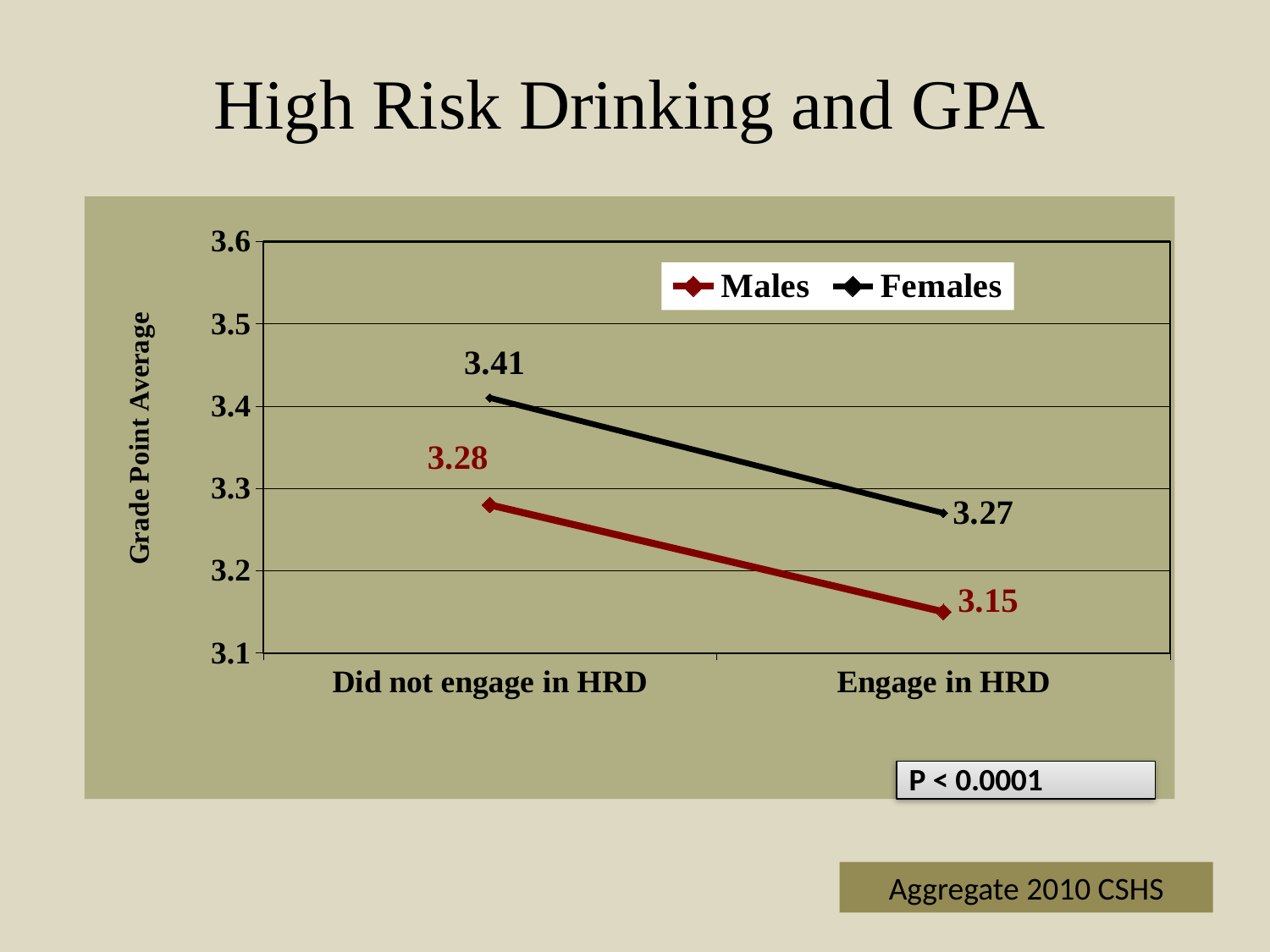
What is the difference between the Females GPA and the Males GPA for those who engage in HRD? 0.12 What is the label of the y axis? Grade Point Average What is the GPA for Females who did not engage in HRD? 3.41 How much does the Females GPA drop from 'Did not engage in HRD' to 'Engage in HRD'? 0.14 How many categories are shown on the x axis? 2 What is the GPA for Males who did not engage in HRD? 3.28 How many series does the legend list? 2 What is the GPA for Males who engage in HRD? 3.15 What kind of chart is shown on the slide? line chart Which series has the higher GPA for those who did not engage in HRD? Females What is the GPA for Females who engage in HRD? 3.27 Does the Males GPA rise or fall from 'Did not engage in HRD' to 'Engage in HRD'? fall